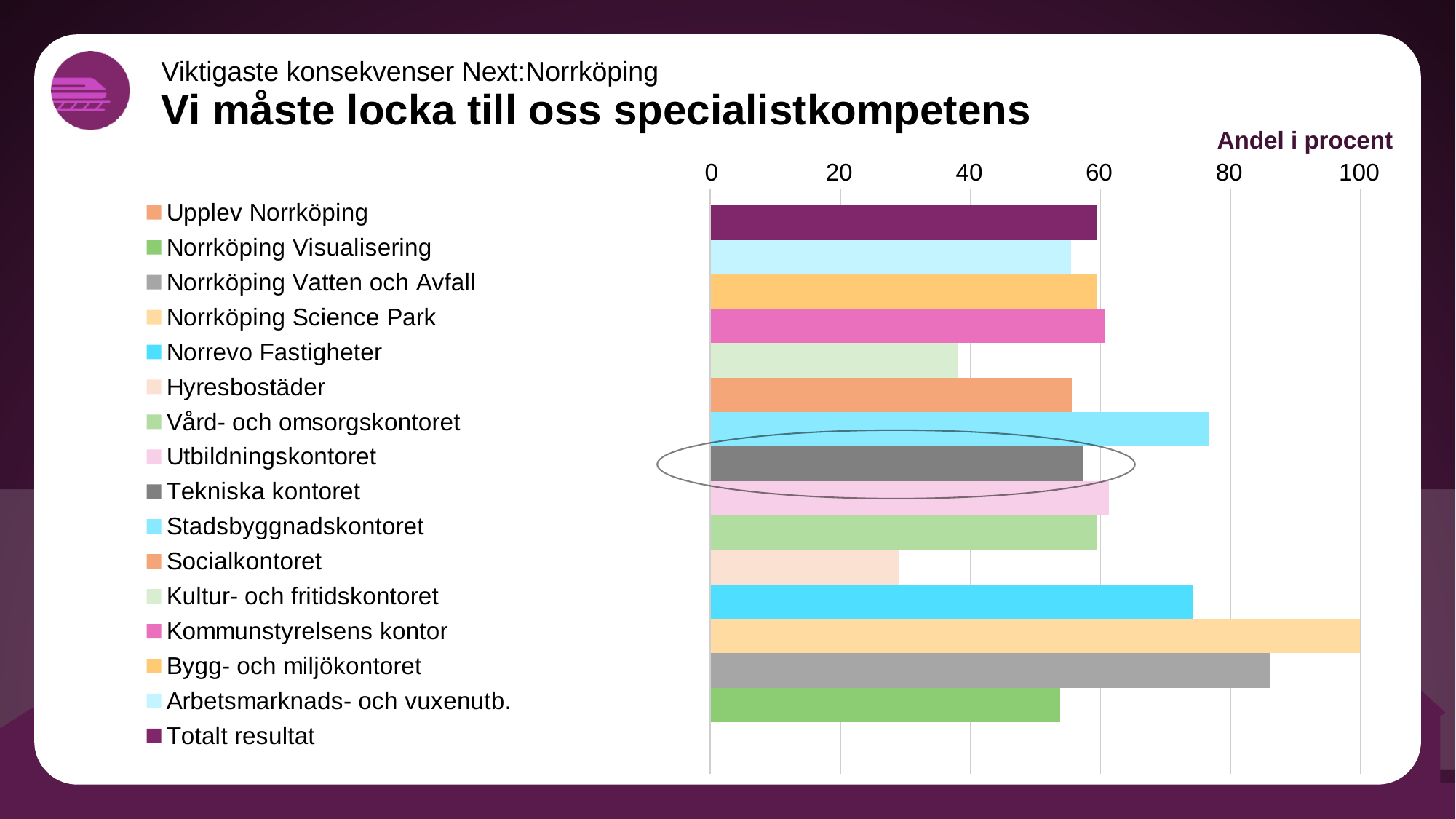
What is the label shown above the horizontal axis of the chart? Andel i procent What kind of chart is shown on the slide? Bar chart Which is larger, the value for Stadsbyggnadskontoret or the value for Socialkontoret? Stadsbyggnadskontoret What is the value for Norrköping Science Park? 100 Which is larger, the value for Norrköping Vatten och Avfall or the value for Norrevo Fastigheter? Norrköping Vatten och Avfall Which series has the highest value in the chart? Norrköping Science Park How many series does the legend list? 16 Which series' bar is circled in the chart? Tekniska kontoret Is the value for Stadsbyggnadskontoret greater or less than 60? greater Is the value for Norrköping Vatten och Avfall greater or less than 80? greater Is the value for Norrevo Fastigheter greater or less than 60? greater